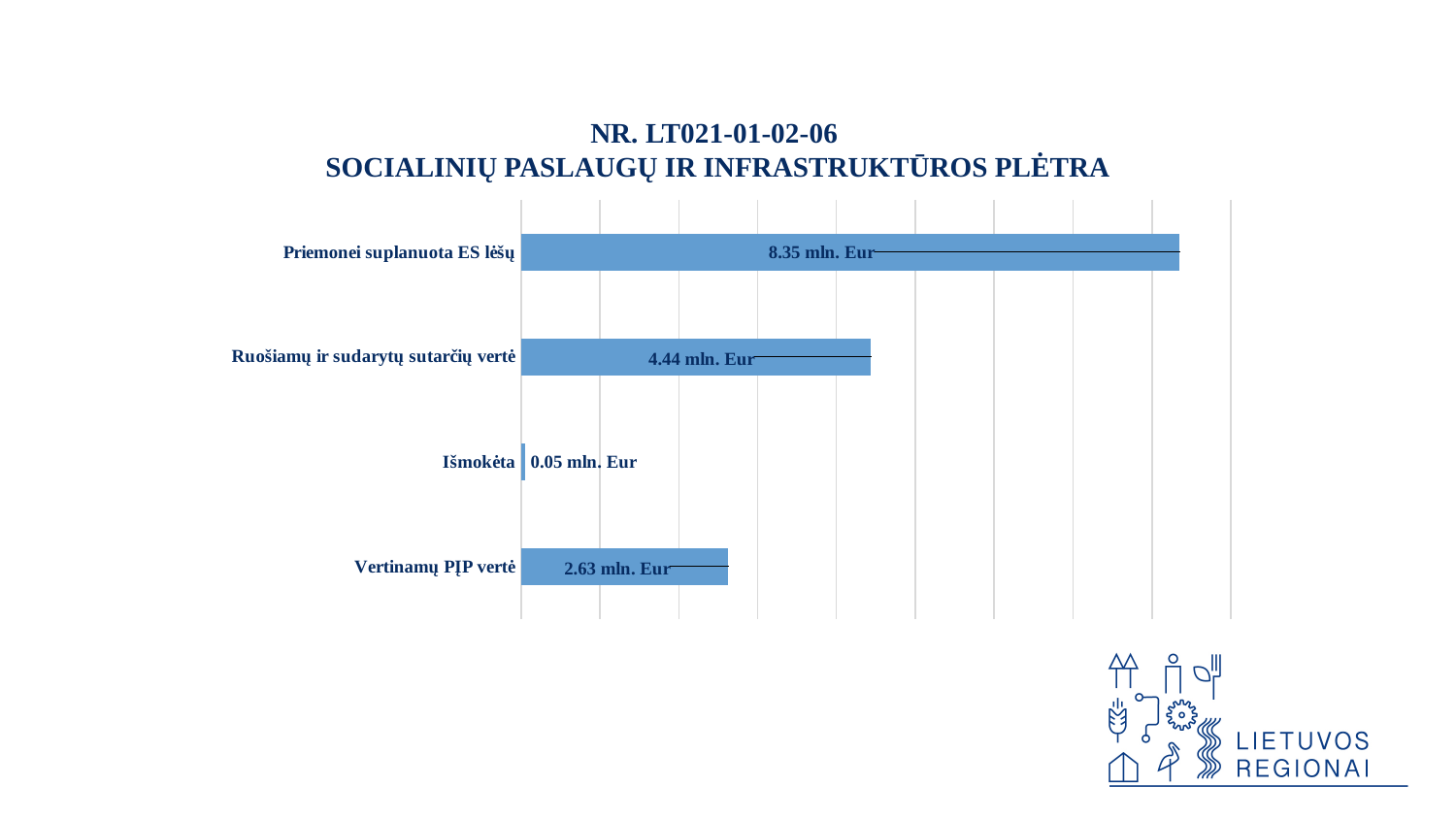
Which category has the lowest value? Išmokėta What is the value for "Vertinamų PĮP vertė"? 2.63 mln. Eur What kind of chart is shown on the slide? Bar chart What is the value for "Išmokėta"? 0.05 mln. Eur Which is larger: "Vertinamų PĮP vertė" or "Išmokėta"? Vertinamų PĮP vertė How many categories are shown in the chart? 4 What is the title of the chart? NR. LT021-01-02-06 SOCIALINIŲ PASLAUGŲ IR INFRASTRUKTŪROS PLĖTRA Which category has the highest value? Priemonei suplanuota ES lėšų What is the difference between "Ruošiamų ir sudarytų sutarčių vertė" and "Vertinamų PĮP vertė"? 1.81 mln. Eur What is the value for "Priemonei suplanuota ES lėšų"? 8.35 mln. Eur What is the value for "Ruošiamų ir sudarytų sutarčių vertė"? 4.44 mln. Eur What is the difference between "Priemonei suplanuota ES lėšų" and "Ruošiamų ir sudarytų sutarčių vertė"? 3.91 mln. Eur